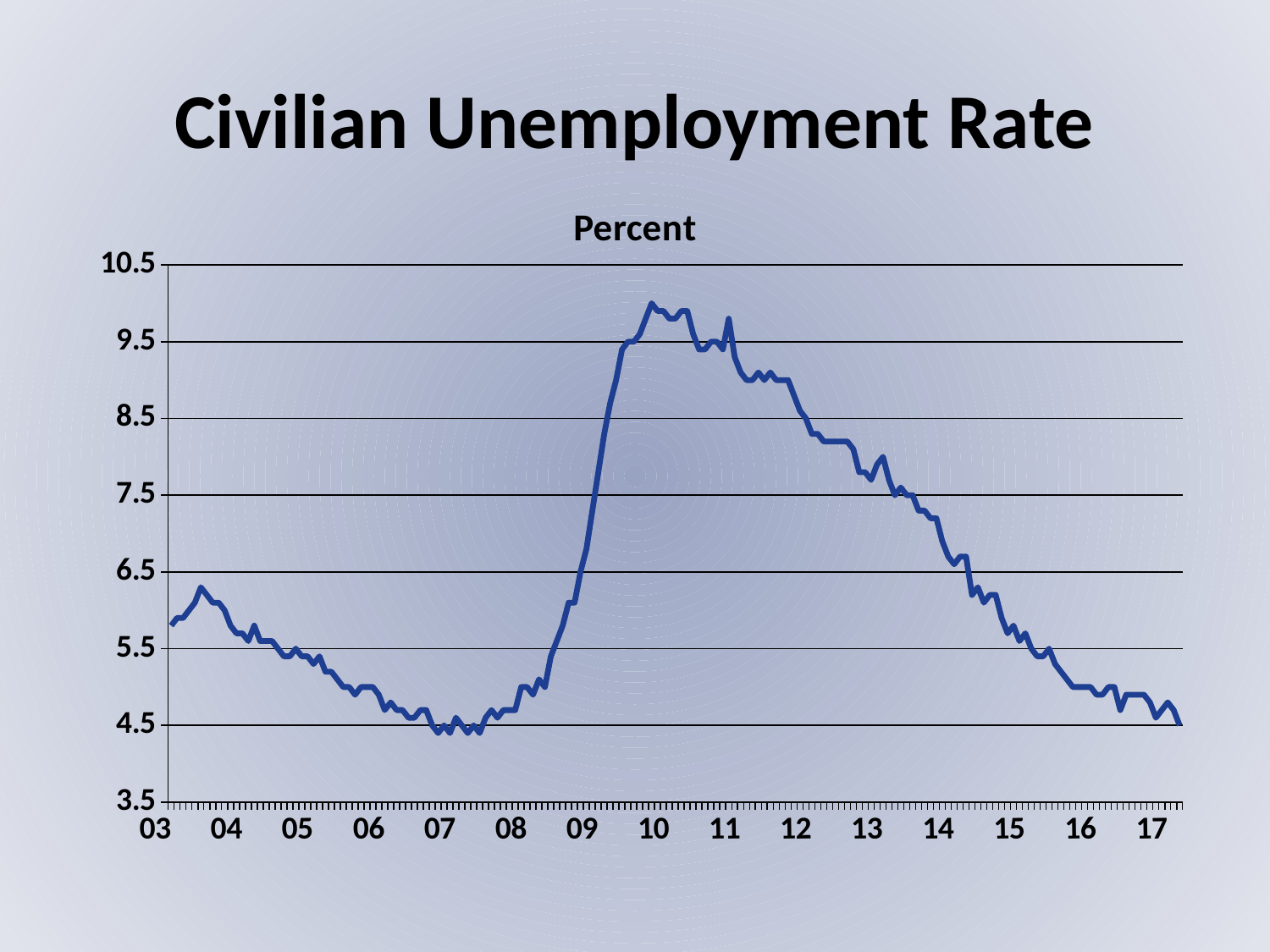
Does the line rise or fall between 10 and 17? fall Is the value at 13 greater or less than 8.5? less Does the line rise or fall between 08 and 09? rise How many year labels are shown on the x axis? 15 Is the value at 07 greater or less than 5.5? less Which is larger, the value at 10 or the value at 07? 10 What is the title of the chart? Civilian Unemployment Rate Is the value at the peak of the line around 10 greater or less than 9.5? greater What kind of chart is shown on the slide? line chart What unit label is shown above the chart's y axis? Percent